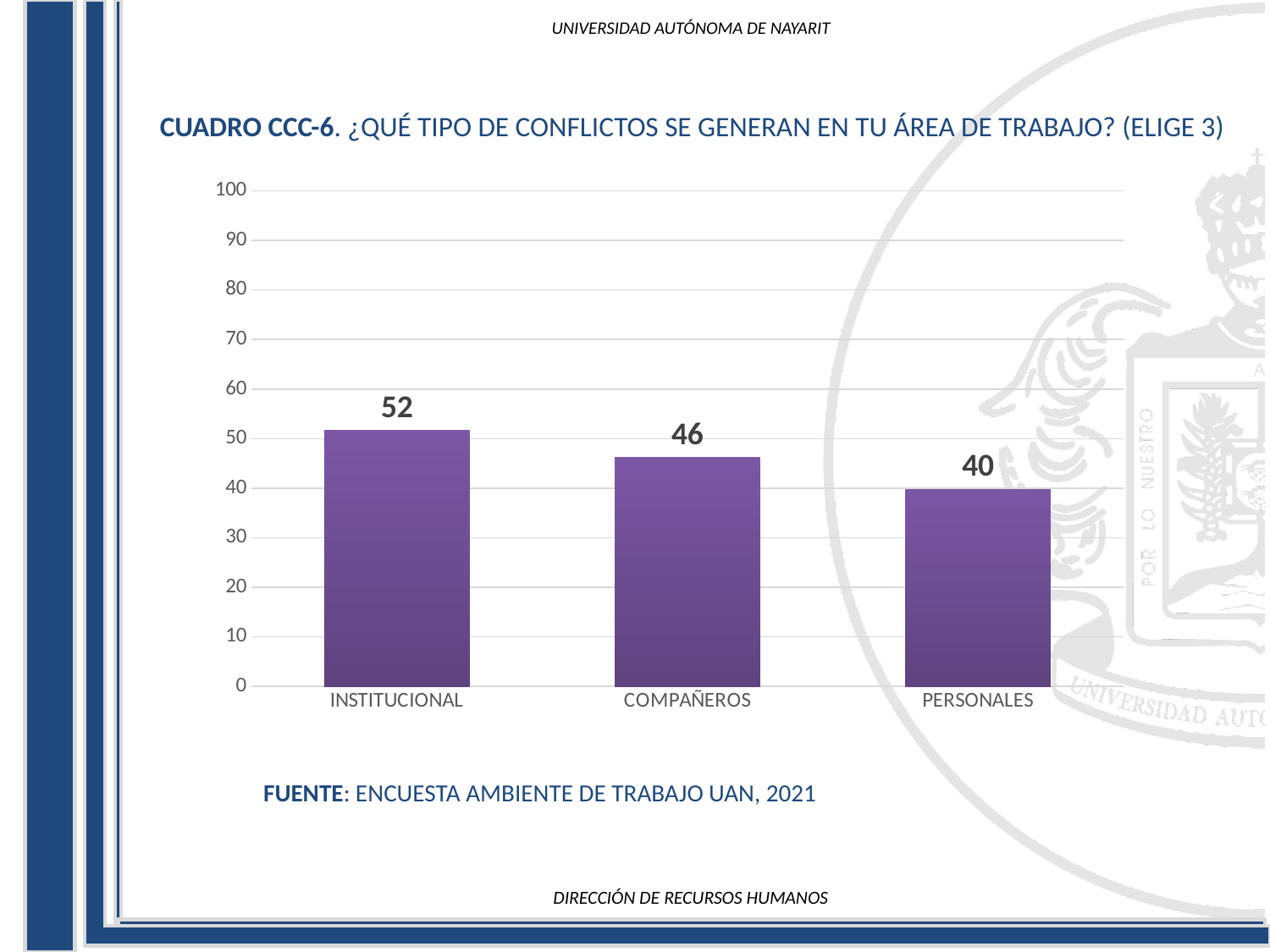
Which category has the lowest value? PERSONALES What is the difference between the values for COMPAÑEROS and PERSONALES? 6 Is the value for INSTITUCIONAL greater or less than 50? greater How many categories are shown on the x axis? 3 Which is larger, the value for COMPAÑEROS or the value for PERSONALES? COMPAÑEROS What is the difference between the values for INSTITUCIONAL and PERSONALES? 12 What is the value for INSTITUCIONAL? 52 What is the value for COMPAÑEROS? 46 What is the value for PERSONALES? 40 Which category has the highest value? INSTITUCIONAL Do the values rise or fall from left to right along the x axis? fall What kind of chart is shown on the slide? bar chart